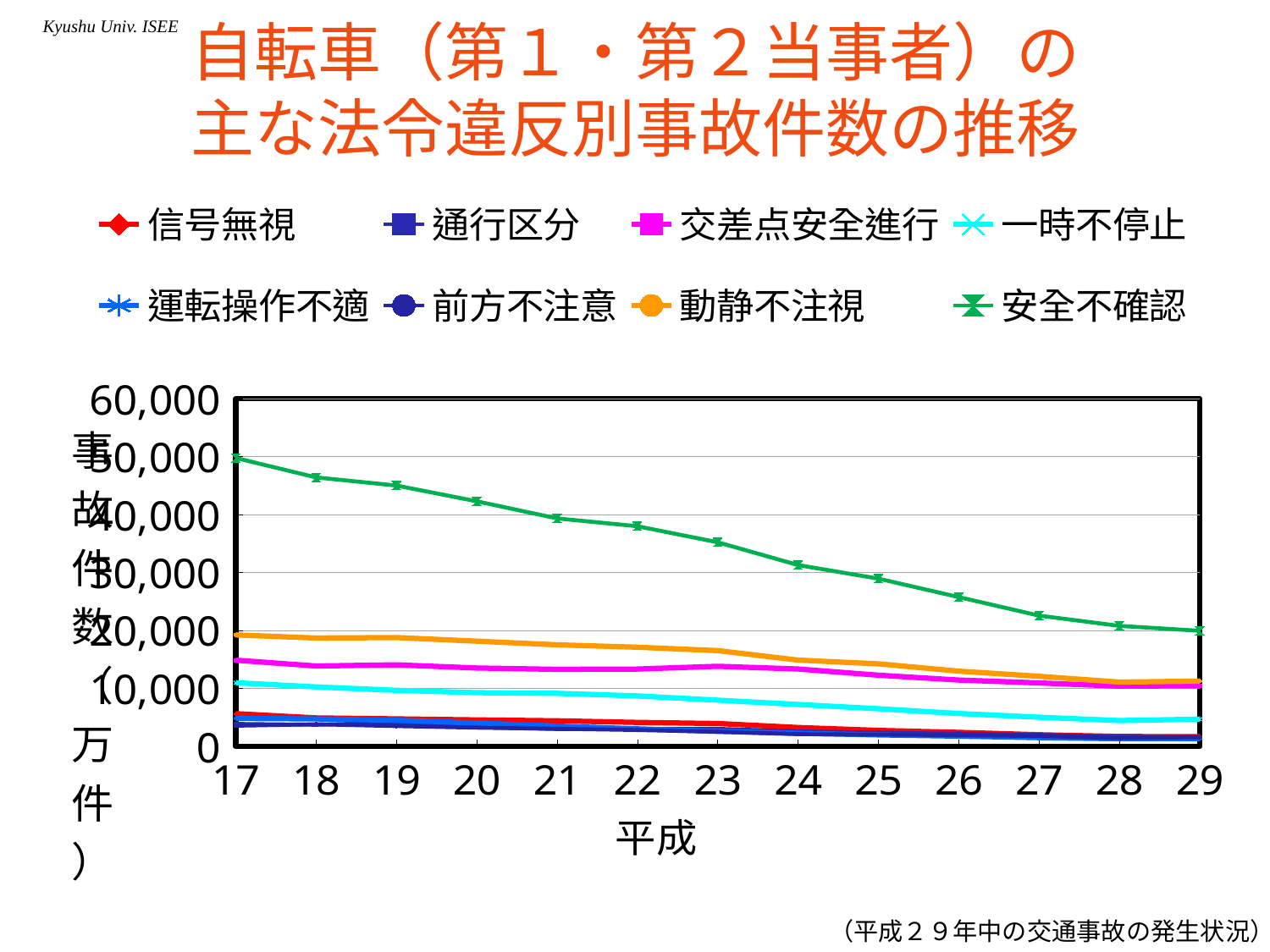
Is the value for 安全不確認 in 平成17 greater or less than 40,000? greater Does the 安全不確認 series rise or fall from 平成17 to 平成29? fall How many years (points) are plotted along the x axis? 13 Is the value for 動静不注視 in 平成17 greater or less than 30,000? less What is the first year shown on the x axis? 17 What kind of chart is shown on the slide? line chart How many series does the legend list? 8 In 平成17, which is larger: 安全不確認 or 動静不注視? 安全不確認 What is the label of the x axis? 平成 Is the value for 安全不確認 in 平成29 greater or less than 30,000? less Which series has the highest values throughout the chart? 安全不確認